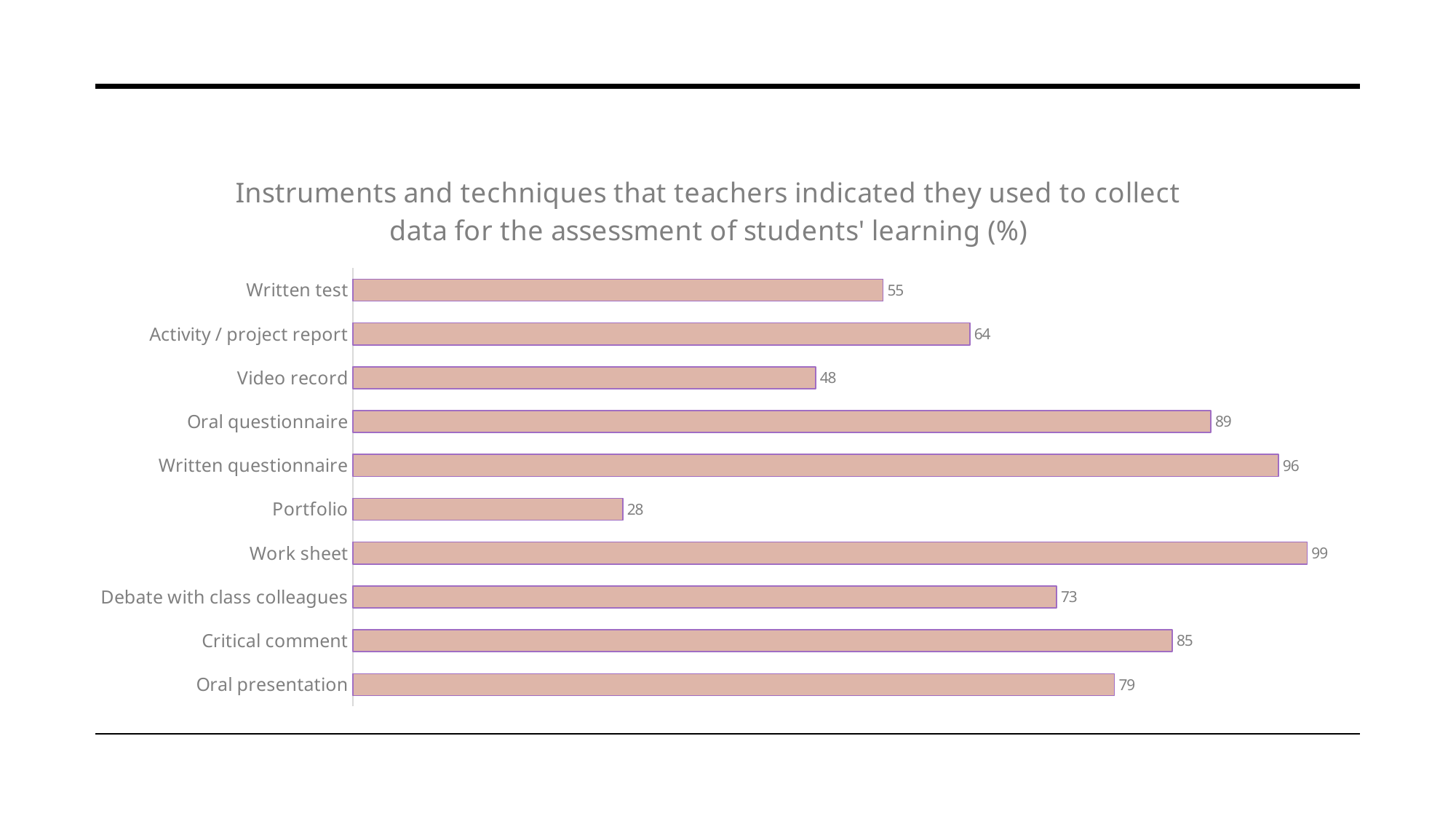
What is the difference between the values for Written questionnaire and Written test? 41 How many categories are shown in the chart? 10 What is the difference between the values for Activity / project report and Video record? 16 Which category has the highest value? Work sheet What value is shown for Debate with class colleagues? 73 What value is shown for Oral questionnaire? 89 What is the title of the chart? Instruments and techniques that teachers indicated they used to collect data for the assessment of students' learning (%) Which category has the lowest value? Portfolio Which is larger, the value for Critical comment or the value for Oral presentation? Critical comment What value is shown for Portfolio? 28 What value is shown for Work sheet? 99 What kind of chart is shown on the slide? Bar chart